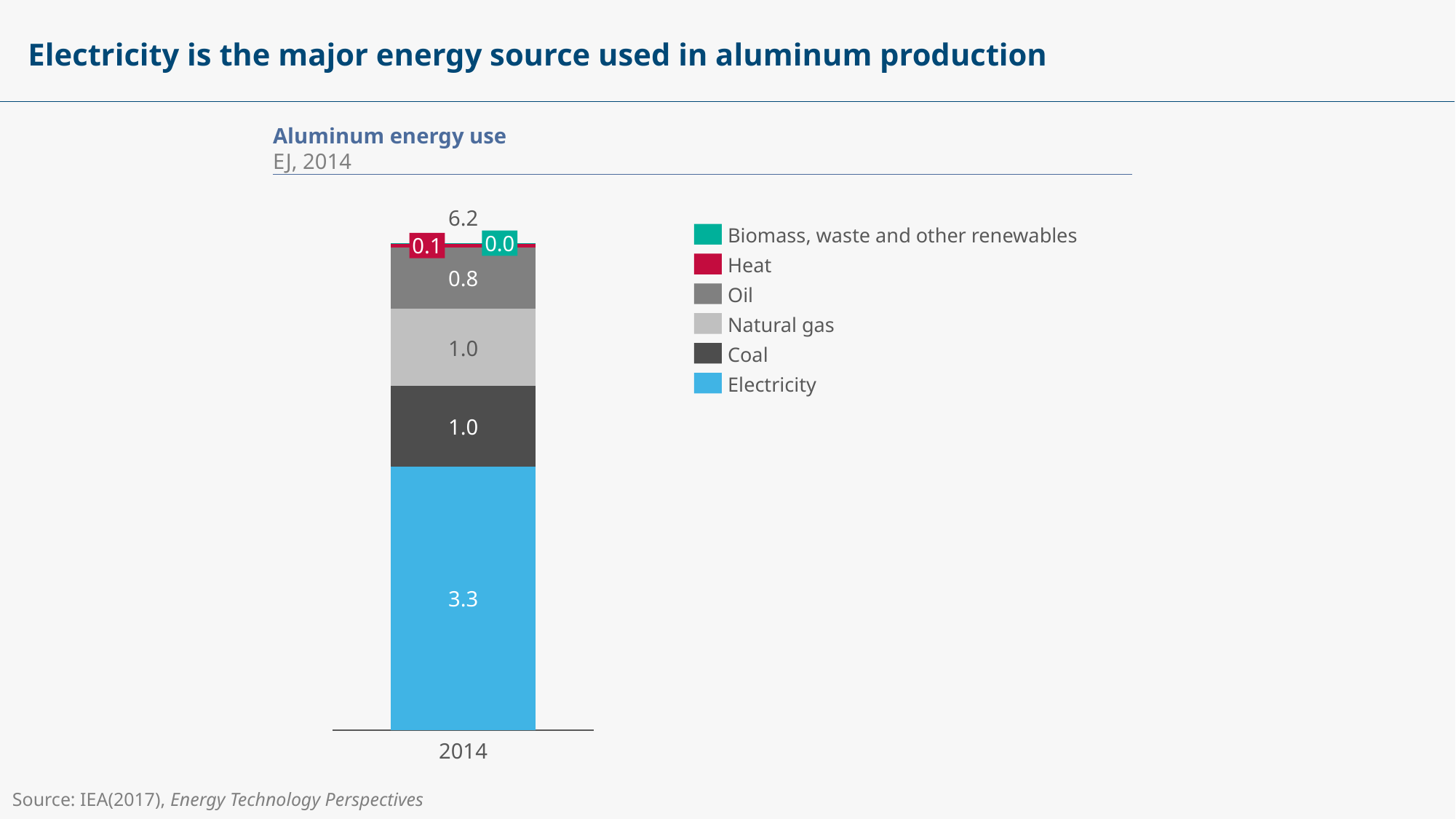
What is the value for Oil in the Aluminum energy use chart? 0.8 What kind of chart is the Aluminum energy use chart? Stacked bar chart Which energy source has the highest value in the Aluminum energy use chart? Electricity Which is larger in the Aluminum energy use chart, Oil or Natural gas? Natural gas What is the value for Biomass, waste and other renewables in the Aluminum energy use chart? 0.0 What is the value for Heat in the Aluminum energy use chart? 0.1 What is the value for Electricity in the Aluminum energy use chart? 3.3 How many series does the legend of the Aluminum energy use chart list? 6 What is the value for Natural gas in the Aluminum energy use chart? 1.0 What is the total of the stacked bar for 2014 in the Aluminum energy use chart? 6.2 Which energy source has the lowest value in the Aluminum energy use chart? Biomass, waste and other renewables What is the difference between the Electricity value and the Coal value in the Aluminum energy use chart? 2.3